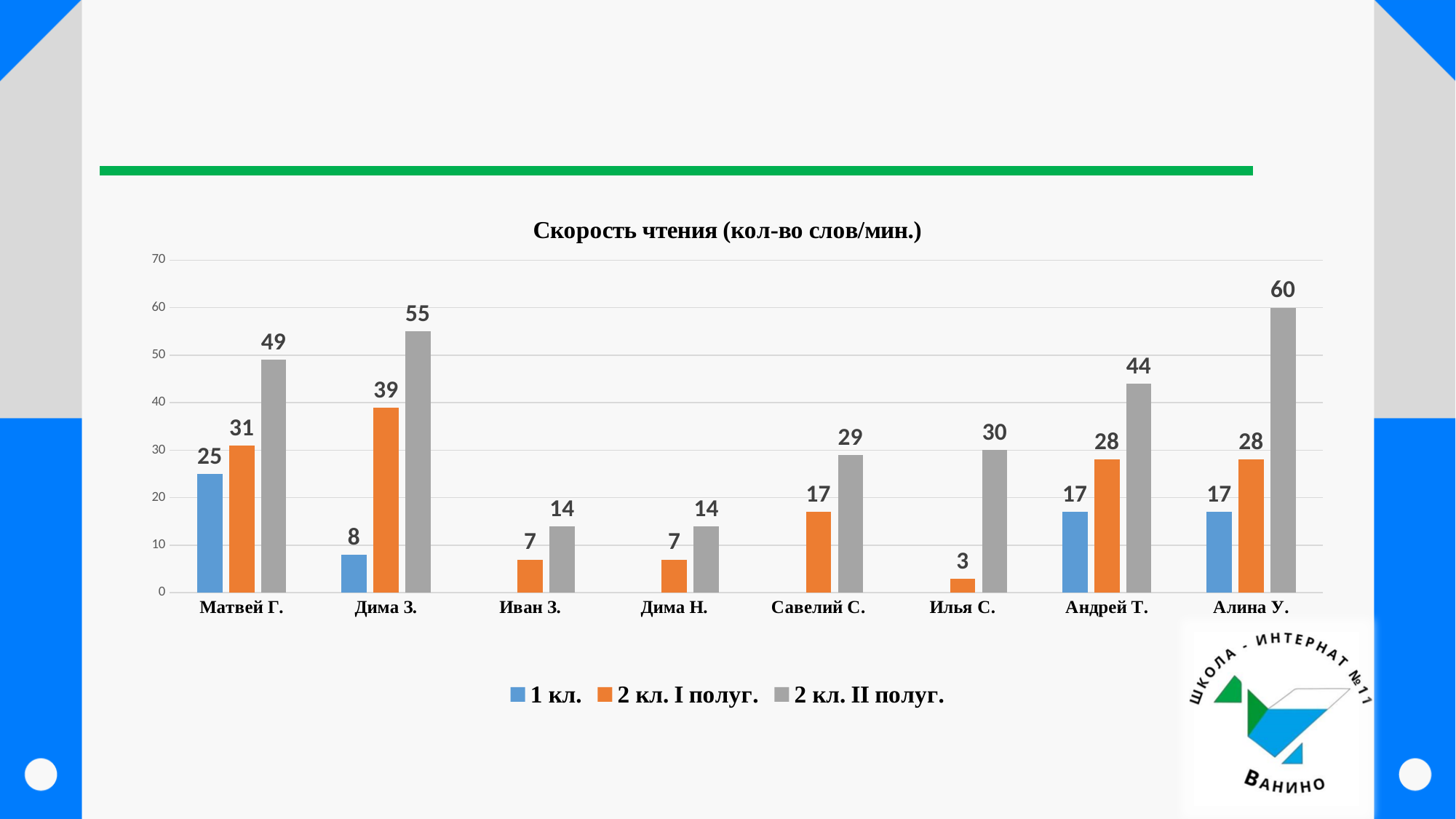
What is the difference between the 2 кл. II полуг. value and the 2 кл. I полуг. value for Андрей Т.? 16 Is the 2 кл. II полуг. value for Дима З. greater or less than 50? greater Which student has the lowest value in the series 2 кл. I полуг.? Илья С. For Матвей Г., do the values rise or fall from 1 кл. to 2 кл. II полуг.? rise Which is larger: the 2 кл. II полуг. value for Савелий С. or for Илья С.? Илья С. Which student has the highest value in the series 2 кл. II полуг.? Алина У. How many series does the legend list? 3 What type of chart is shown on the slide? bar chart How many students (categories) are shown on the x axis? 8 What is the value for Дима З. in the series 2 кл. I полуг.? 39 What is the value for Матвей Г. in the series 1 кл.? 25 What is the title of the chart? Скорость чтения (кол-во слов/мин.)